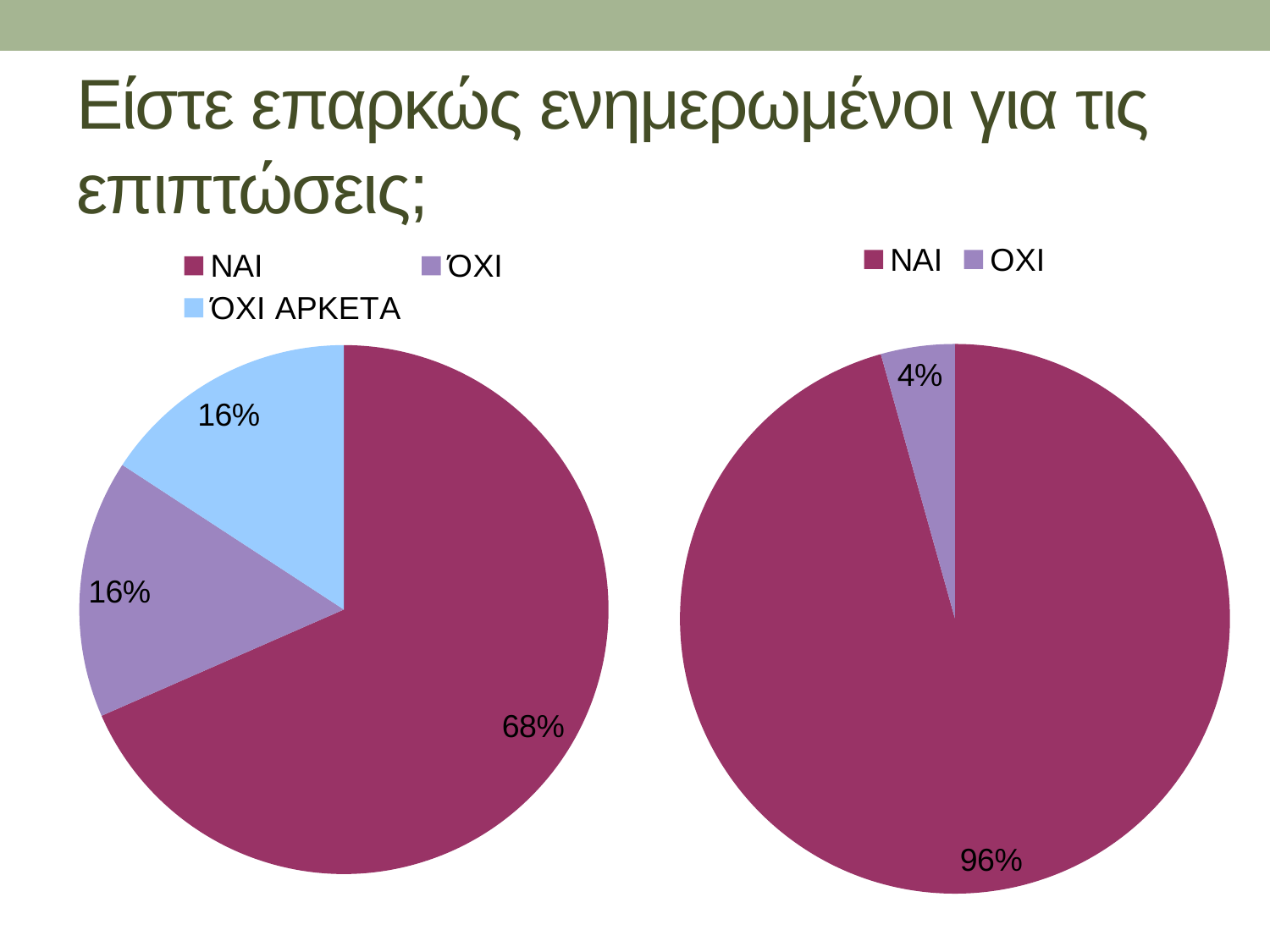
In the left pie chart, which category has the largest slice? ΝΑΙ In the left pie chart, what percentage is shown for ΌΧΙ ΑΡΚΕΤΑ? 16% In the right pie chart, what percentage is shown for ΝΑΙ? 96% What is the difference between the ΝΑΙ and ΟΧΙ percentages in the right pie chart? 92% How many entries does the legend of the right pie chart list? 2 In the left pie chart, what percentage is shown for ΝΑΙ? 68% In the right pie chart, what percentage is shown for ΟΧΙ? 4% How many slices does the left pie chart have? 3 In the right pie chart, which category has the smallest slice? ΟΧΙ What type of chart is the chart on the left of the slide? Pie chart What is the difference between the ΝΑΙ and ΌΧΙ percentages in the left pie chart? 52% Which is larger: ΝΑΙ in the left pie chart or ΝΑΙ in the right pie chart? ΝΑΙ in the right pie chart